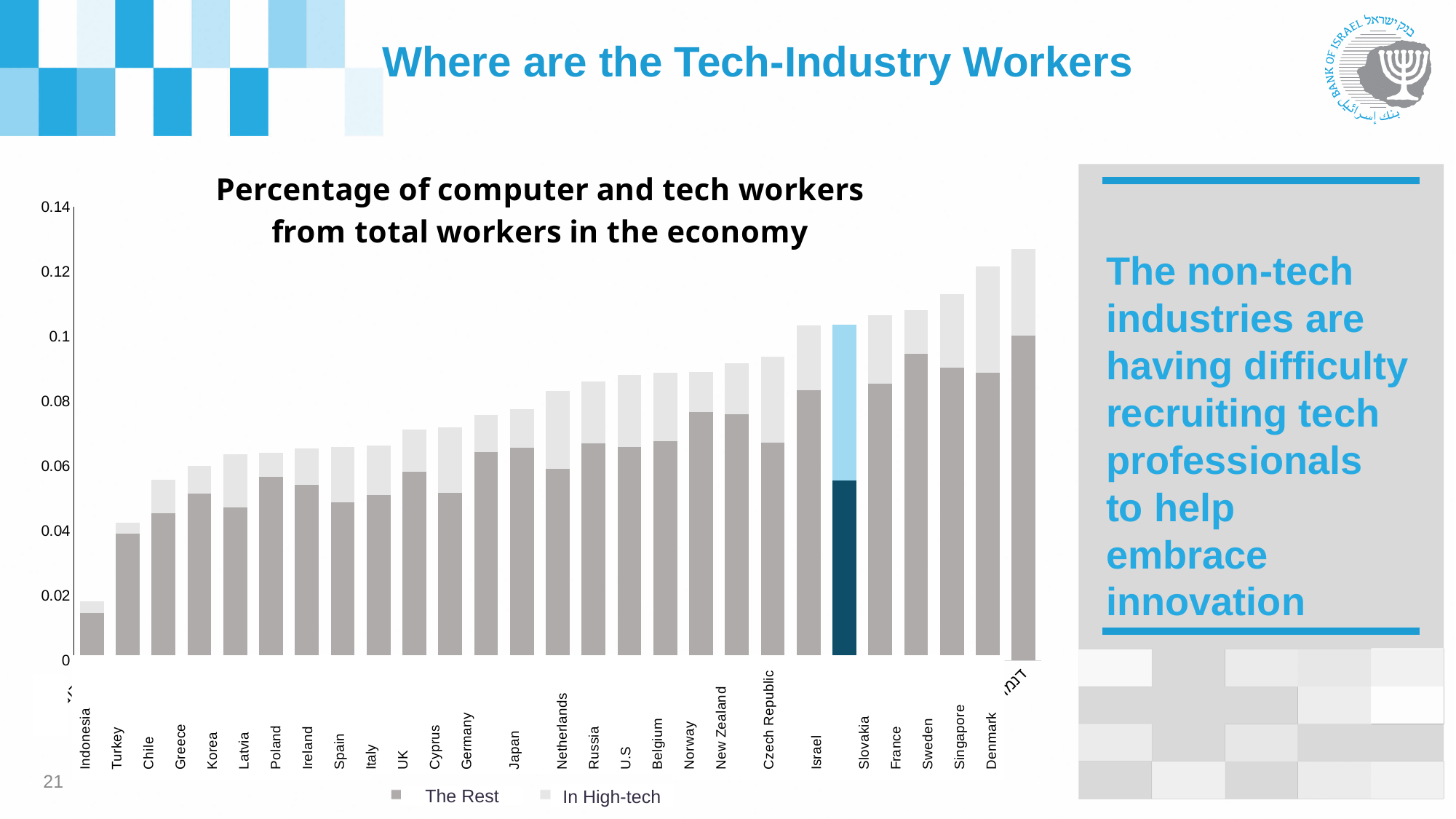
What is the title of the chart? Percentage of computer and tech workers from total workers in the economy Is the total bar for Chile greater or less than 0.06? less Which has the taller total bar, Denmark or Singapore? Denmark What are the two series named in the chart legend? The Rest; In High-tech Is the 'The Rest' value for Israel greater or less than 0.06? less Is the total bar for Belgium greater or less than 0.08? greater What kind of chart is shown on the slide? Stacked bar chart Do the total bar heights generally rise or fall moving from left to right along the x axis? Rise Which country has the lowest total bar in the chart? Indonesia How many series does the chart legend list? 2